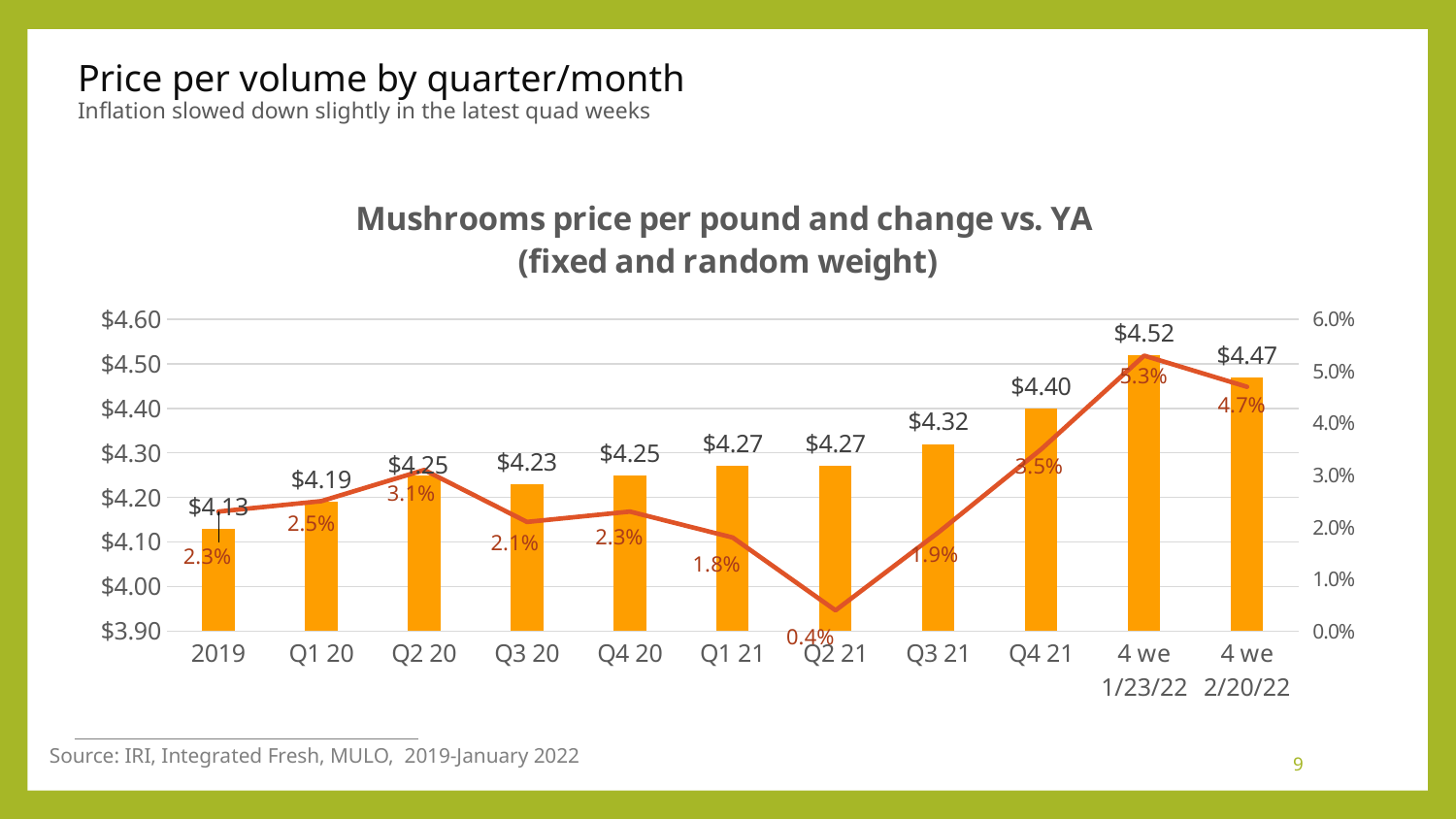
What is the price per pound for the 4 weeks ending 2/20/22? $4.47 Which period has the lowest price per pound? 2019 What kind of chart is this? Combined bar and line chart What is the difference in change vs. YA between 4 we 1/23/22 and Q4 21? 1.8% What is the title of the chart? Mushrooms price per pound and change vs. YA (fixed and random weight) Which is higher, the price per pound in Q3 20 or in Q4 20? Q4 20 What is the mushrooms price per pound for Q4 21? $4.40 What is the change vs. YA shown for Q2 21? 0.4% Which period has the lowest change vs. YA? Q2 21 How many periods are shown on the x axis? 11 Which period has the highest price per pound? 4 we 1/23/22 What is the difference in price per pound between 4 we 1/23/22 and 4 we 2/20/22? $0.05